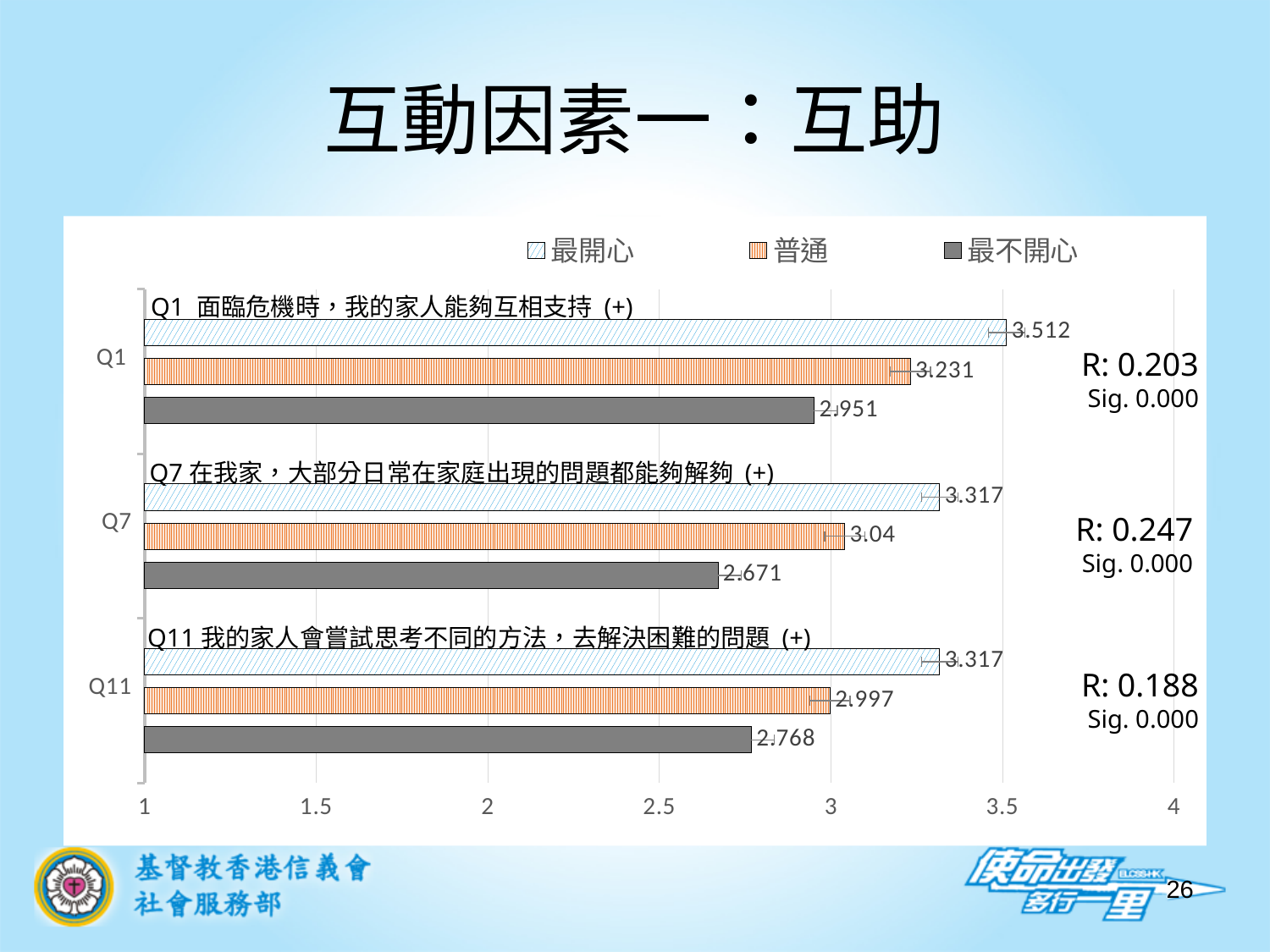
Which category has the highest 最開心 value? Q1 Which category has the lowest 最不開心 value? Q7 How many series does the legend list? 3 What is the value of 最不開心 for Q11? 2.768 What R value is shown next to Q7? R: 0.247 What is the value of 最開心 for Q1? 3.512 What is the value of 普通 for Q7? 3.04 How many question categories (Q1, Q7, Q11) are plotted on the chart? 3 Which is larger: the 普通 value for Q1 or the 普通 value for Q11? Q1 What kind of chart is shown on the slide? bar chart What is the difference between the 最開心 and 最不開心 values for Q1? 0.561 Is the 最不開心 value for Q7 greater or less than 3? less